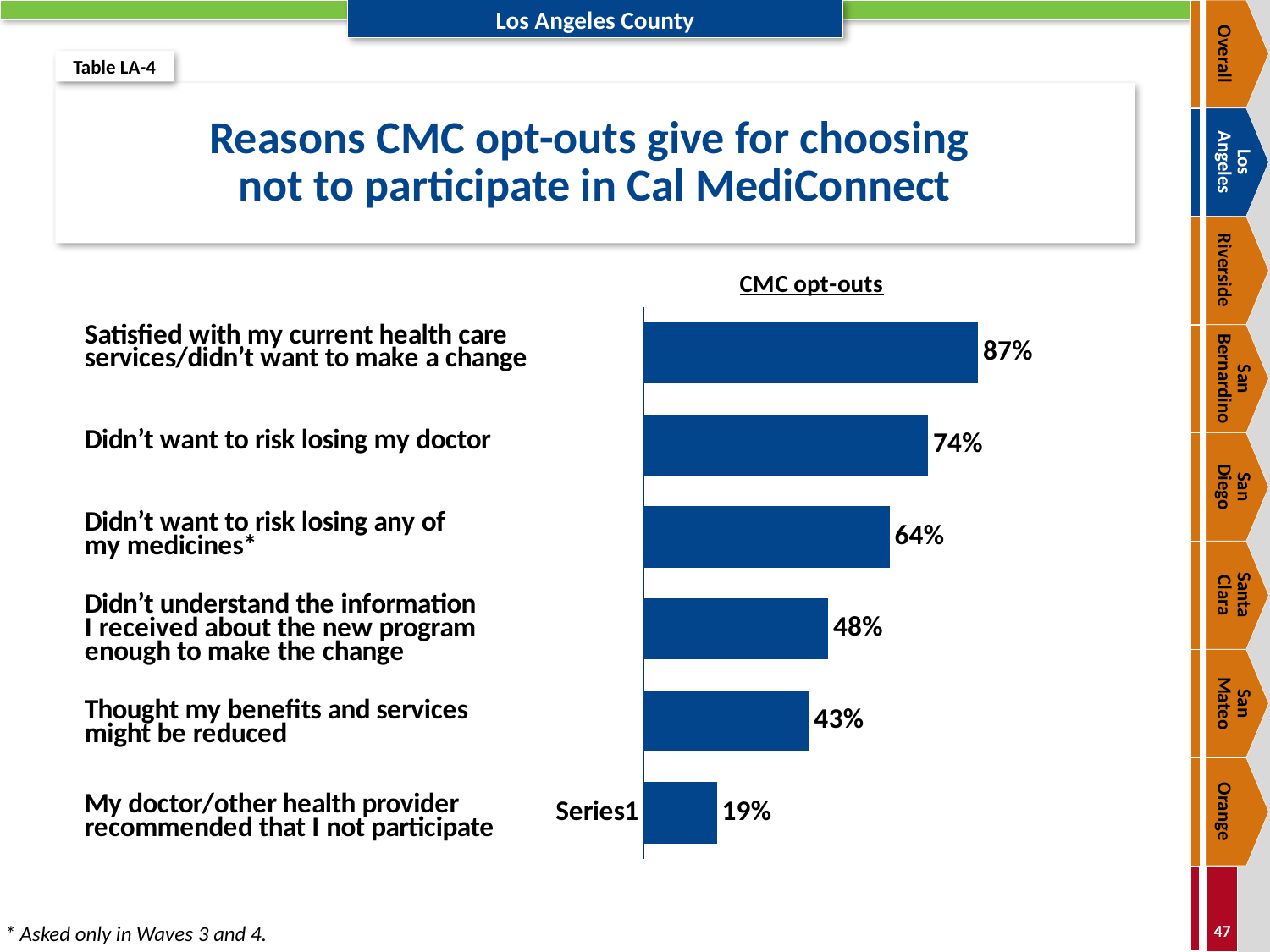
What percentage of CMC opt-outs said they were satisfied with their current health care services/didn't want to make a change? 87% How many reasons are plotted in the chart? 6 What is the difference between the percentage for 'Didn't want to risk losing my doctor' and 'Thought my benefits and services might be reduced'? 31% Which reason has the lowest percentage? My doctor/other health provider recommended that I not participate What is the table number shown on the slide? Table LA-4 What percentage of CMC opt-outs said they didn't want to risk losing their doctor? 74% Which is larger: the percentage for 'Didn't understand the information I received about the new program enough to make the change' or 'Thought my benefits and services might be reduced'? Didn't understand the information I received about the new program enough to make the change What value is shown for 'Didn't want to risk losing any of my medicines'? 64% What kind of chart is shown on the slide? Bar chart Which reason has the highest percentage? Satisfied with my current health care services/didn't want to make a change What is the label shown above the bars in the chart? CMC opt-outs What percentage of CMC opt-outs said their doctor/other health provider recommended that they not participate? 19%